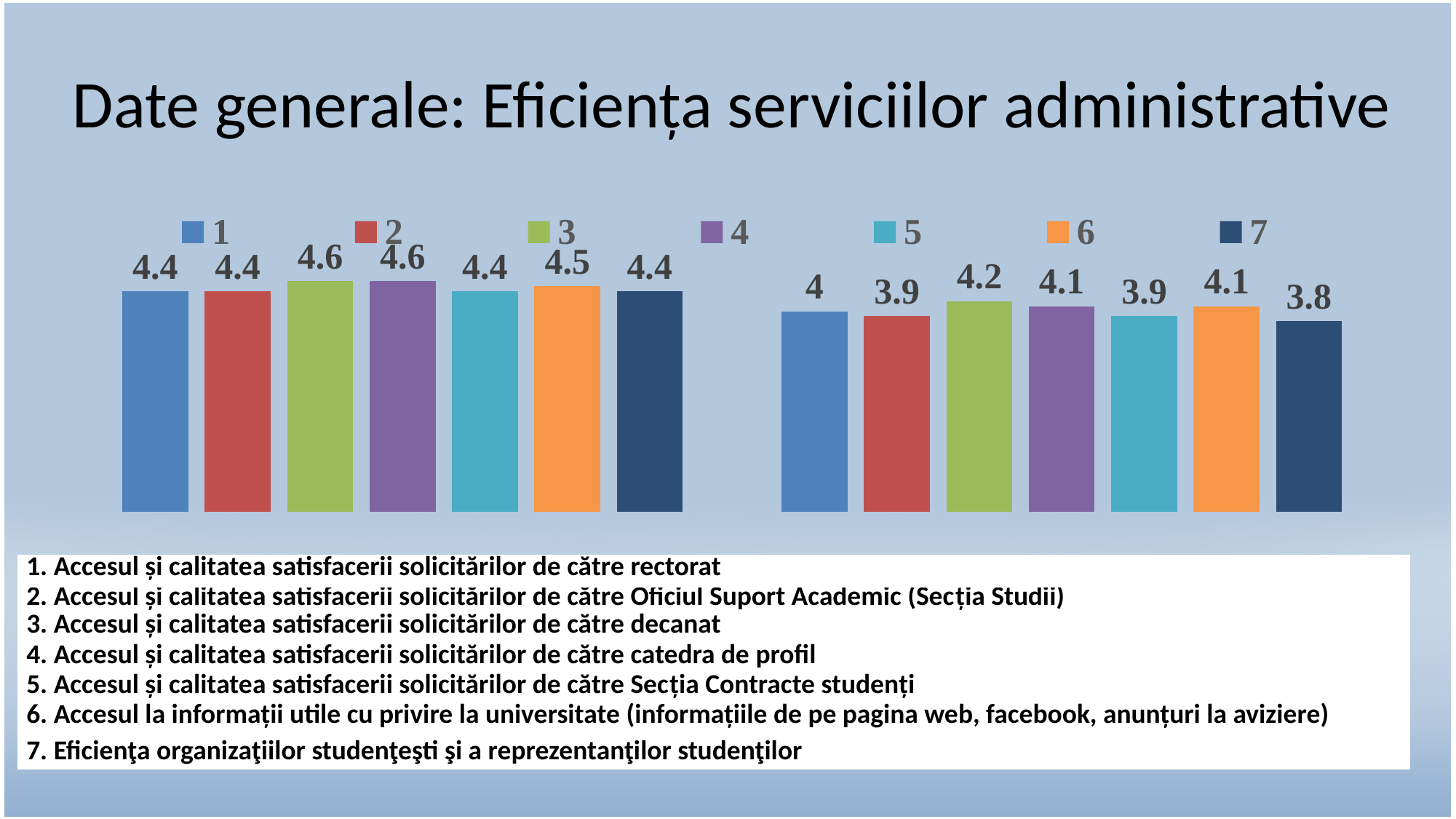
Which series has the lowest value in the right group of bars? 7 How many groups of bars are plotted in the chart? 2 What kind of chart is shown on the slide? bar chart What is the value of series 6 in the left group of bars? 4.5 How many series does the legend list? 7 What is the value of series 3 in the left group of bars? 4.6 What colour is series 7 in the legend? dark blue What is the value of series 7 in the right group of bars? 3.8 What is the value of series 1 in the right group of bars? 4 What is the difference between the value of series 3 in the left group and its value in the right group? 0.4 In the left group of bars, which is larger: series 6 or series 5? series 6 Which series has the highest value in the right group of bars? 3